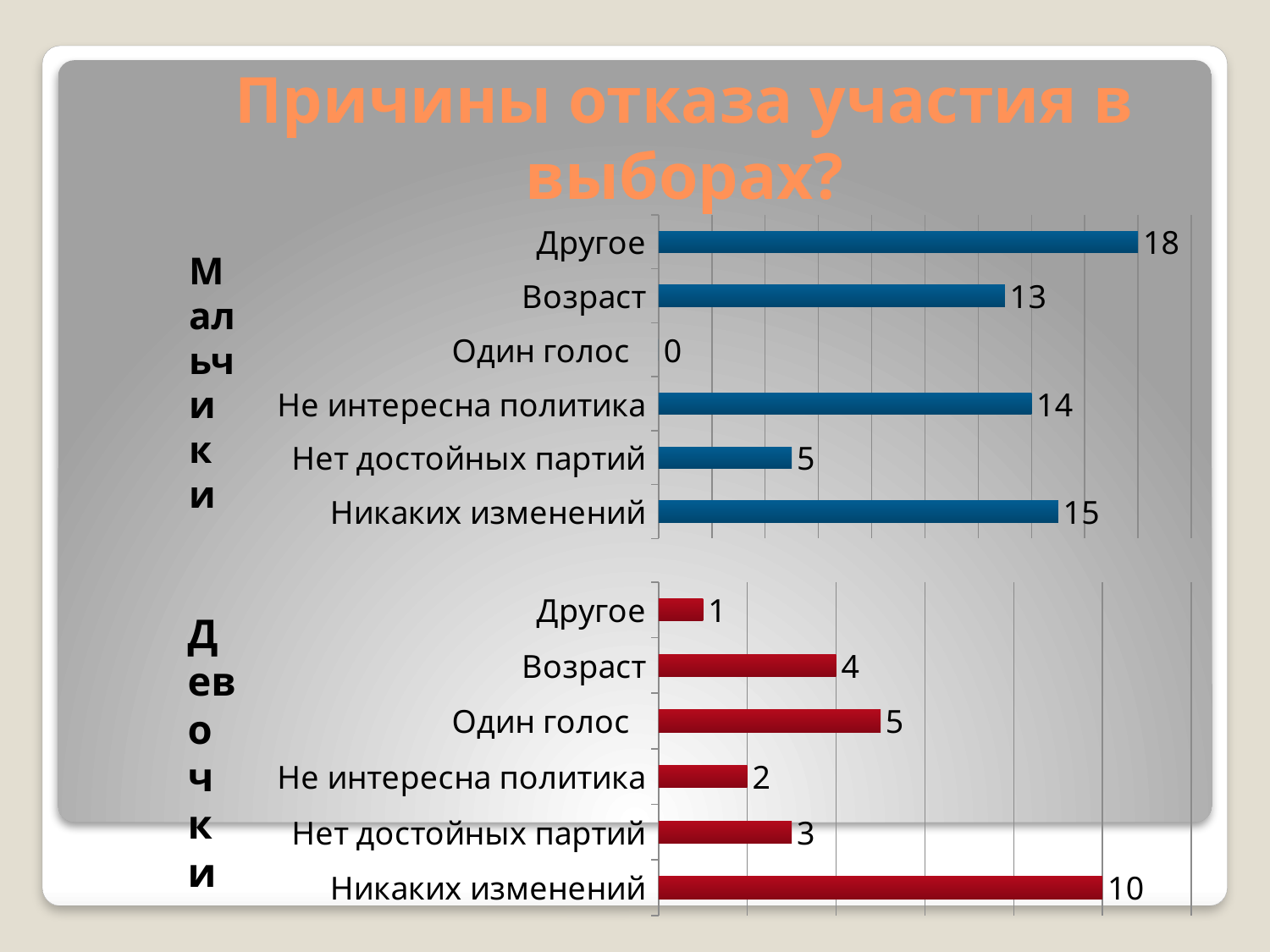
In the bottom chart (Девочки), what is the value for Не интересна политика? 2 In the top chart (Мальчики), what is the value for Другое? 18 In the top chart (Мальчики), which category has the lowest value? Один голос How many categories does the top chart (Мальчики) show? 6 In the bottom chart (Девочки), which category has the lowest value? Другое In the bottom chart (Девочки), what is the value for Никаких изменений? 10 What type of chart is the bottom chart (Девочки)? Bar chart In the top chart (Мальчики), what is the difference between Другое and Возраст? 5 In the bottom chart (Девочки), which category has the highest value? Никаких изменений In the bottom chart (Девочки), which is larger: Возраст or Один голос? Один голос In the top chart (Мальчики), what is the value for Нет достойных партий? 5 In the top chart (Мальчики), which category has the highest value? Другое